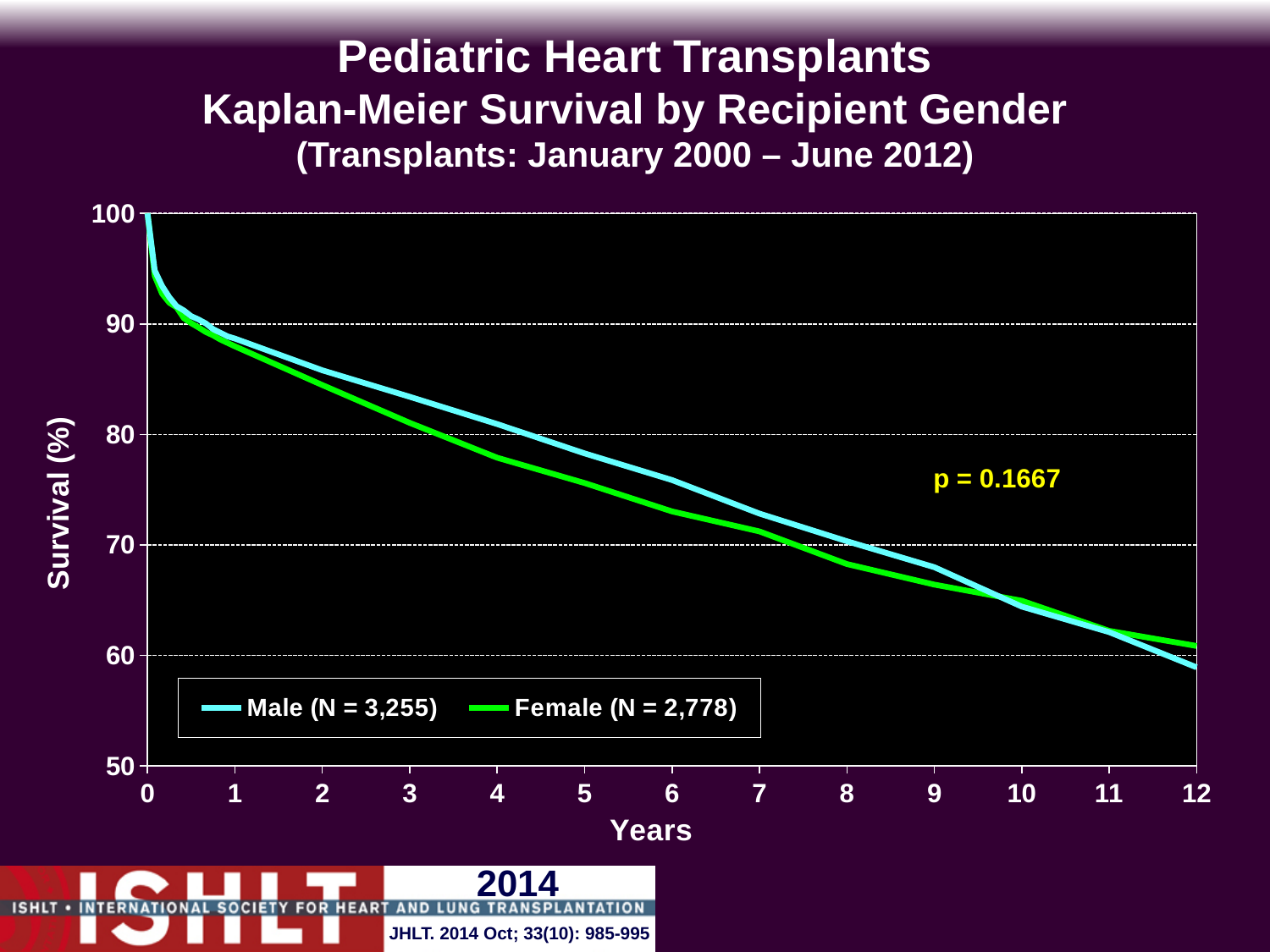
What kind of chart is shown on the slide? line chart At year 12, which series has the higher survival, Male or Female? Female Is the Female survival at year 8 greater or less than 70? less Is the Male survival at year 12 greater or less than 60? less Is the Female survival at year 6 greater or less than 70? greater At year 4, which series has the higher survival, Male or Female? Male Do the survival curves rise or fall as years increase? fall How many series does the legend list? 2 What p-value is printed on the chart? p = 0.1667 What are the two series named in the legend? Male (N = 3,255) and Female (N = 2,778)